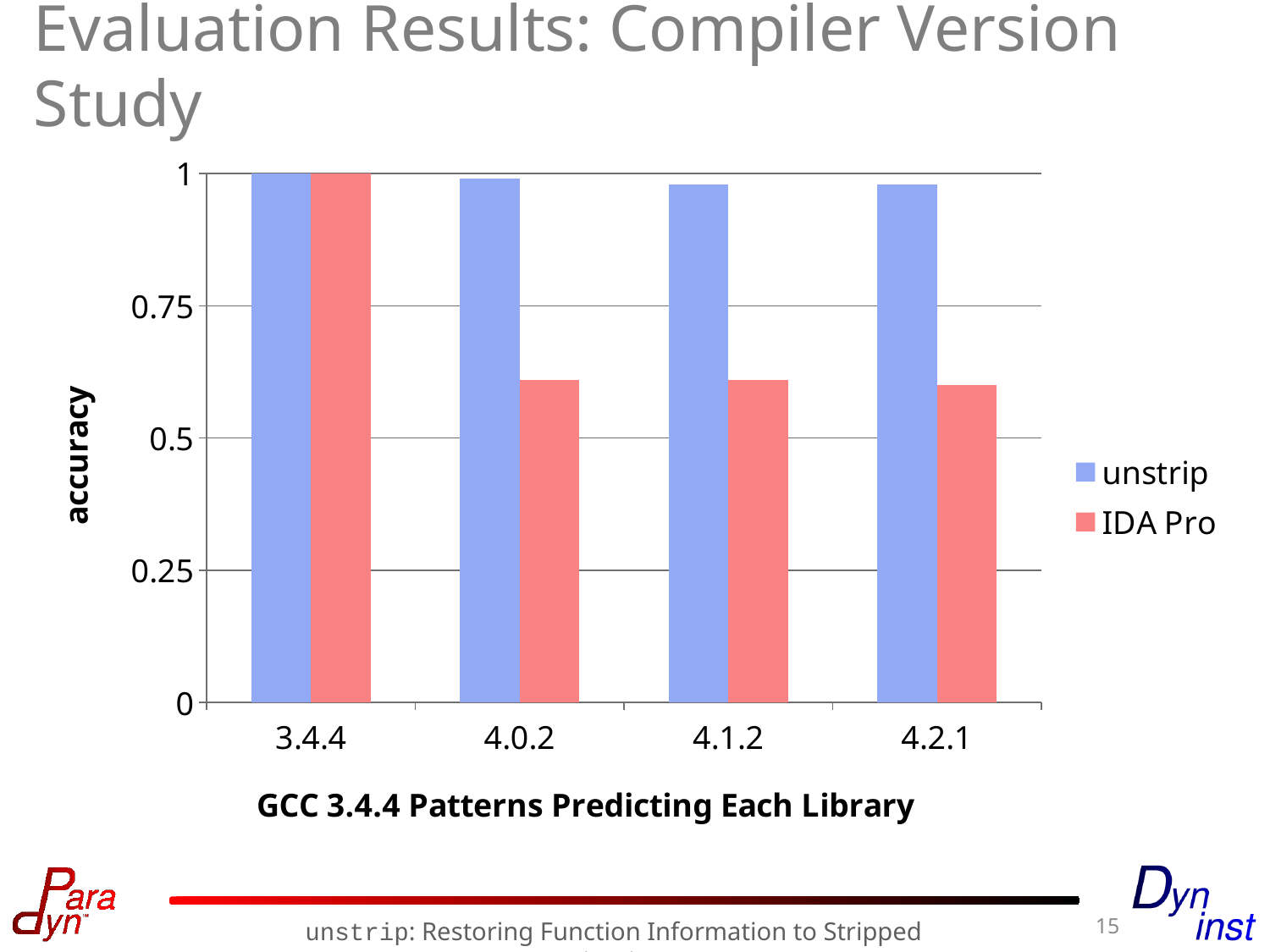
How many compiler versions are shown on the x axis? 4 For version 4.1.2, which has the higher accuracy, unstrip or IDA Pro? unstrip What is the accuracy of unstrip for version 3.4.4? 1 Is the unstrip accuracy for version 4.1.2 greater or less than 0.75? greater What is the label on the y axis? accuracy How many series does the legend list? 2 What kind of chart is shown on the slide? bar chart Is the IDA Pro accuracy for version 4.2.1 greater or less than 0.5? greater What is the accuracy of IDA Pro for version 3.4.4? 1 For which compiler version is the IDA Pro accuracy highest? 3.4.4 Is the IDA Pro accuracy for version 4.0.2 greater or less than 0.75? less What is the title of the chart? GCC 3.4.4 Patterns Predicting Each Library